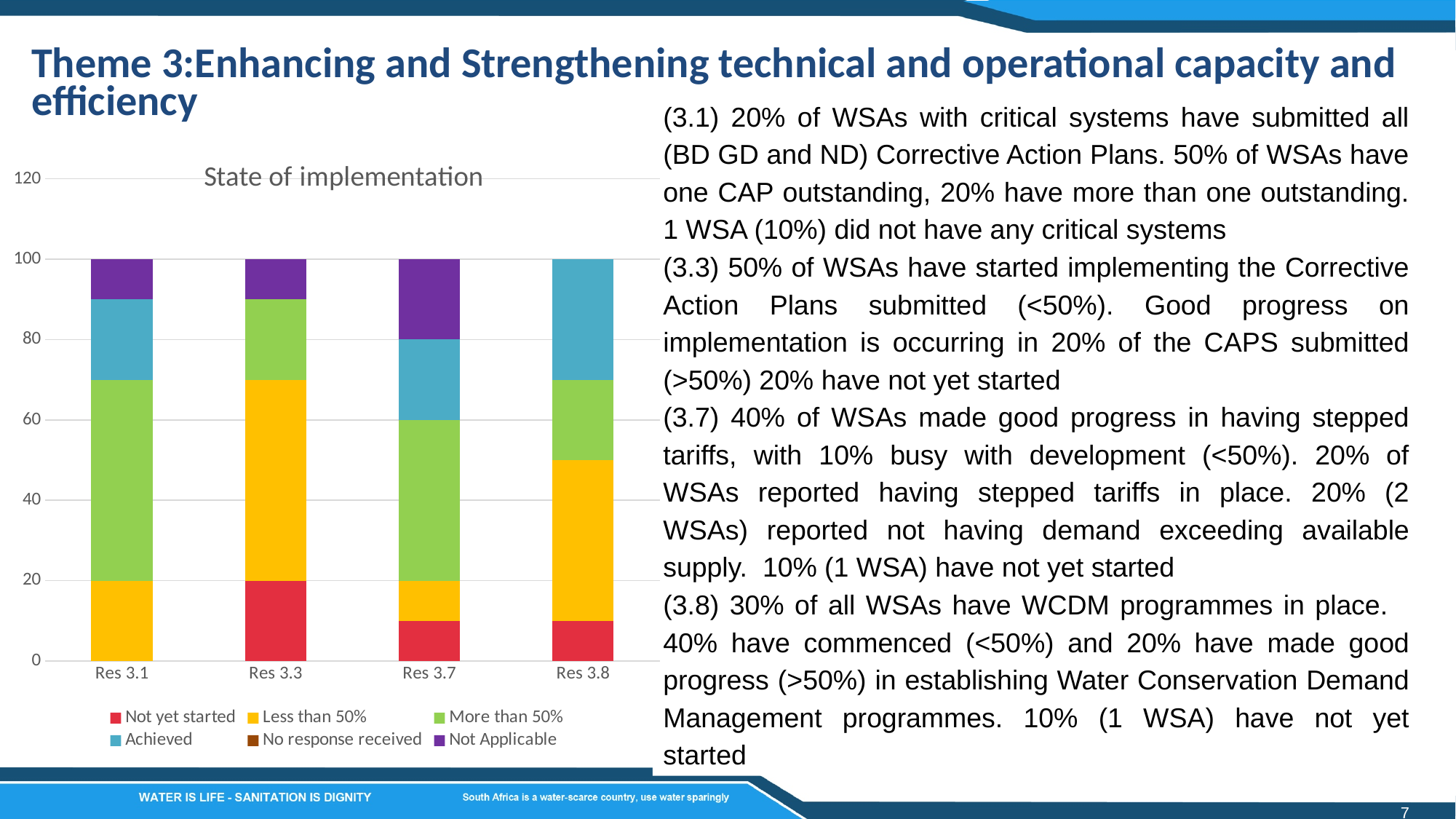
What is the total height of the stacked bar for Res 3.8? 100 What is the title of the chart? State of implementation Which category has no 'Not yet started' segment in its bar? Res 3.1 What kind of chart is shown on the slide? bar chart Is the 'More than 50%' value for Res 3.1 greater or less than 40? greater Is the 'Less than 50%' value for Res 3.8 greater or less than 20? greater How many categories are shown on the x axis of the chart? 4 Which has the larger 'Less than 50%' value, Res 3.1 or Res 3.3? Res 3.3 How many series does the chart legend list? 6 Which category has the largest 'Not Applicable' segment? Res 3.7 What is the total height of the stacked bar for Res 3.1? 100 Which has the larger 'Not yet started' value, Res 3.3 or Res 3.7? Res 3.3